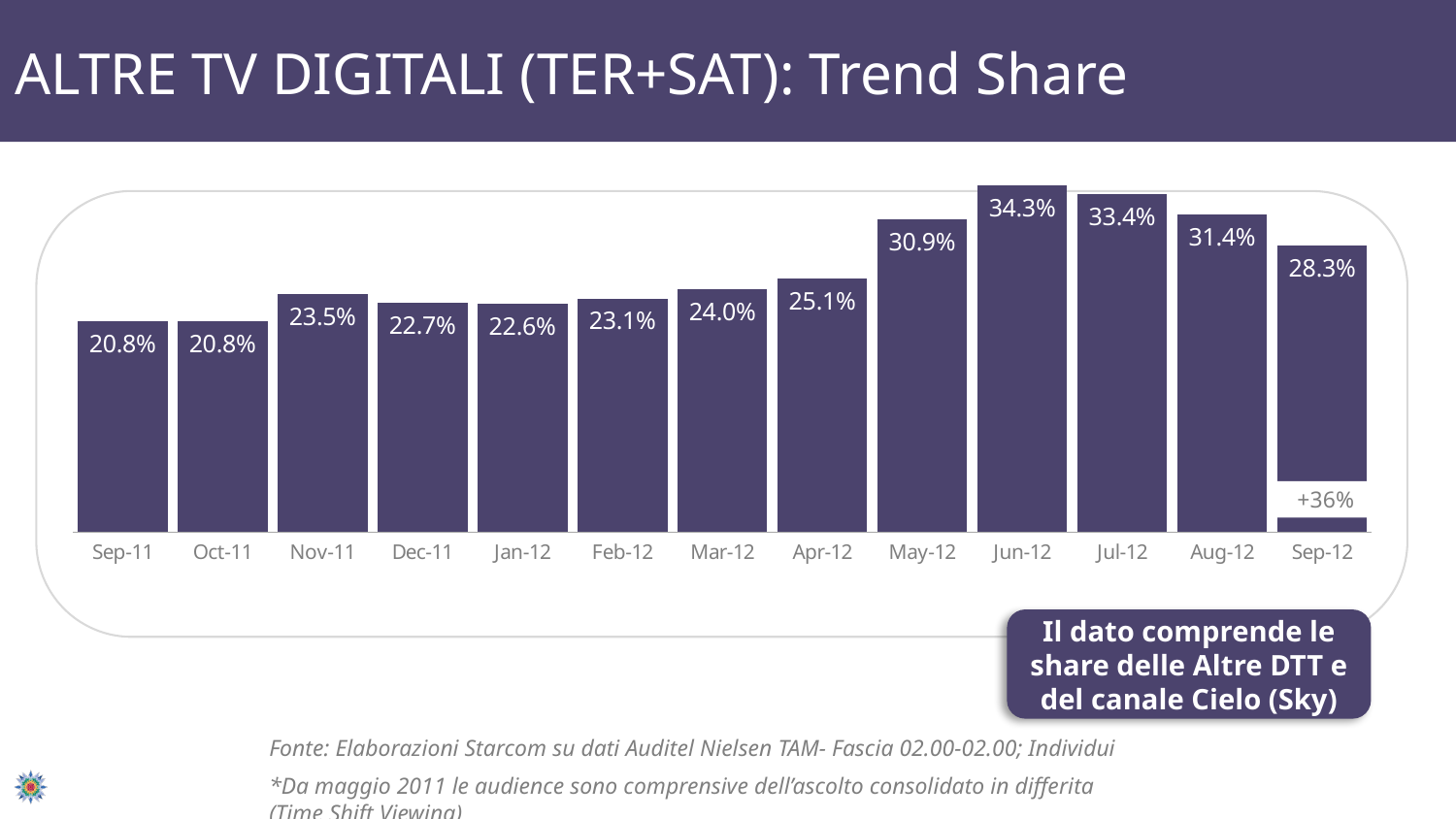
Which months have the lowest share? Sep-11 and Oct-11 How many months are shown on the x axis? 13 What is the share value for Sep-12? 28.3% What percentage change is annotated on the Sep-12 bar? +36% What is the difference between the share for Jun-12 and the share for Sep-11? 13.5% Which month has the highest share? Jun-12 What is the difference between the share for May-12 and the share for Apr-12? 5.8% What kind of chart is shown on the slide? Bar chart What is the share value for Jun-12? 34.3% What is the share value for Sep-11? 20.8% What is the share value for Mar-12? 24.0% Which is larger, the share for Jul-12 or the share for Aug-12? Jul-12